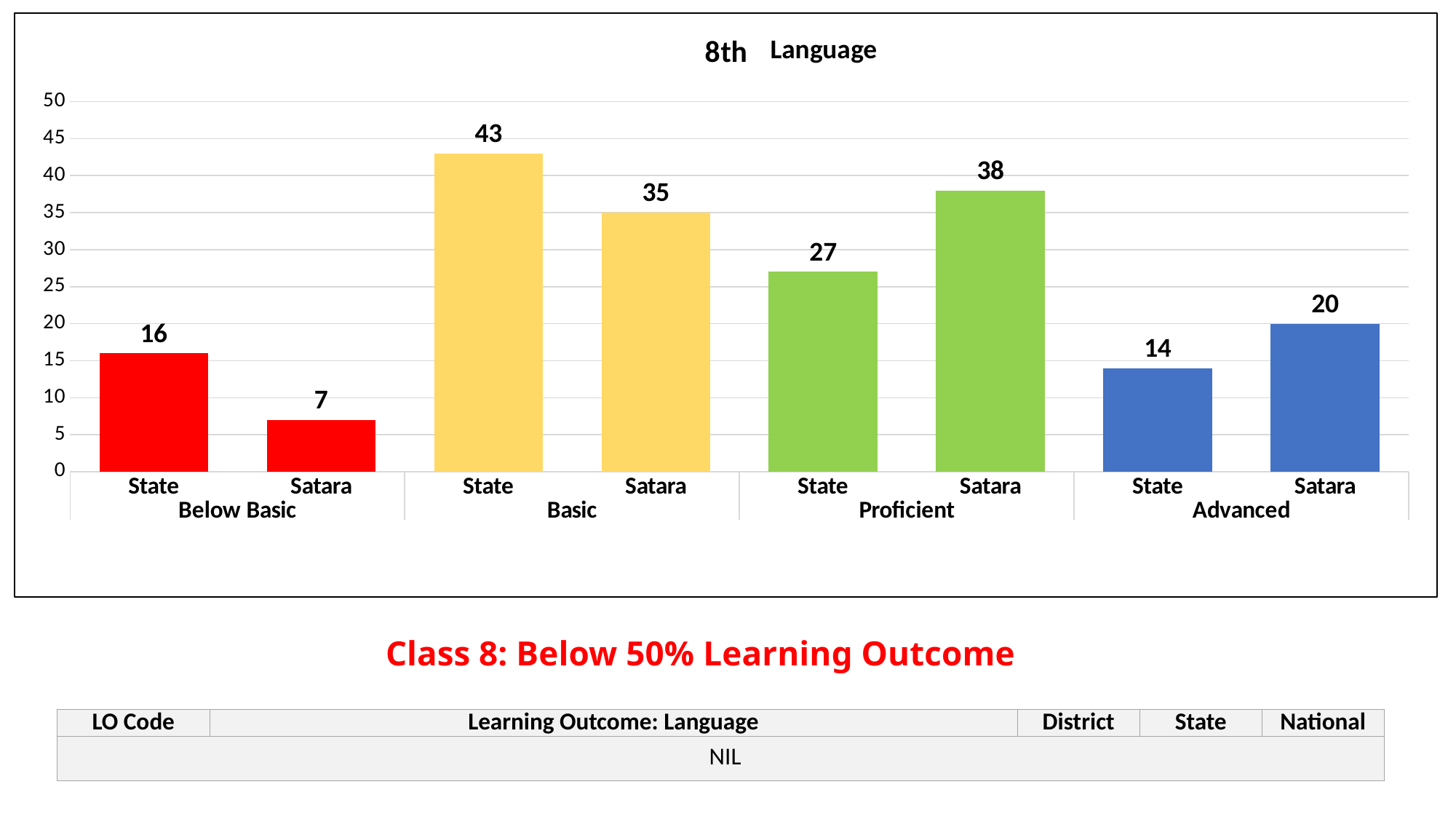
What is the value for Satara in the Basic group? 35 What is the value for Satara in the Proficient group? 38 What kind of chart is shown on the slide? Bar chart What is the difference between the Satara and State values in the Proficient group? 11 In the Advanced group, which is larger, State or Satara? Satara Which bar has the lowest value in the chart? Satara, Below Basic What is the value for State in the Advanced group? 14 What is the difference between the State and Satara values in the Basic group? 8 How many bars are plotted in the chart? 8 What is the title of the chart? 8th Language Which bar has the highest value in the chart? State, Basic What is the value for State in the Below Basic group? 16